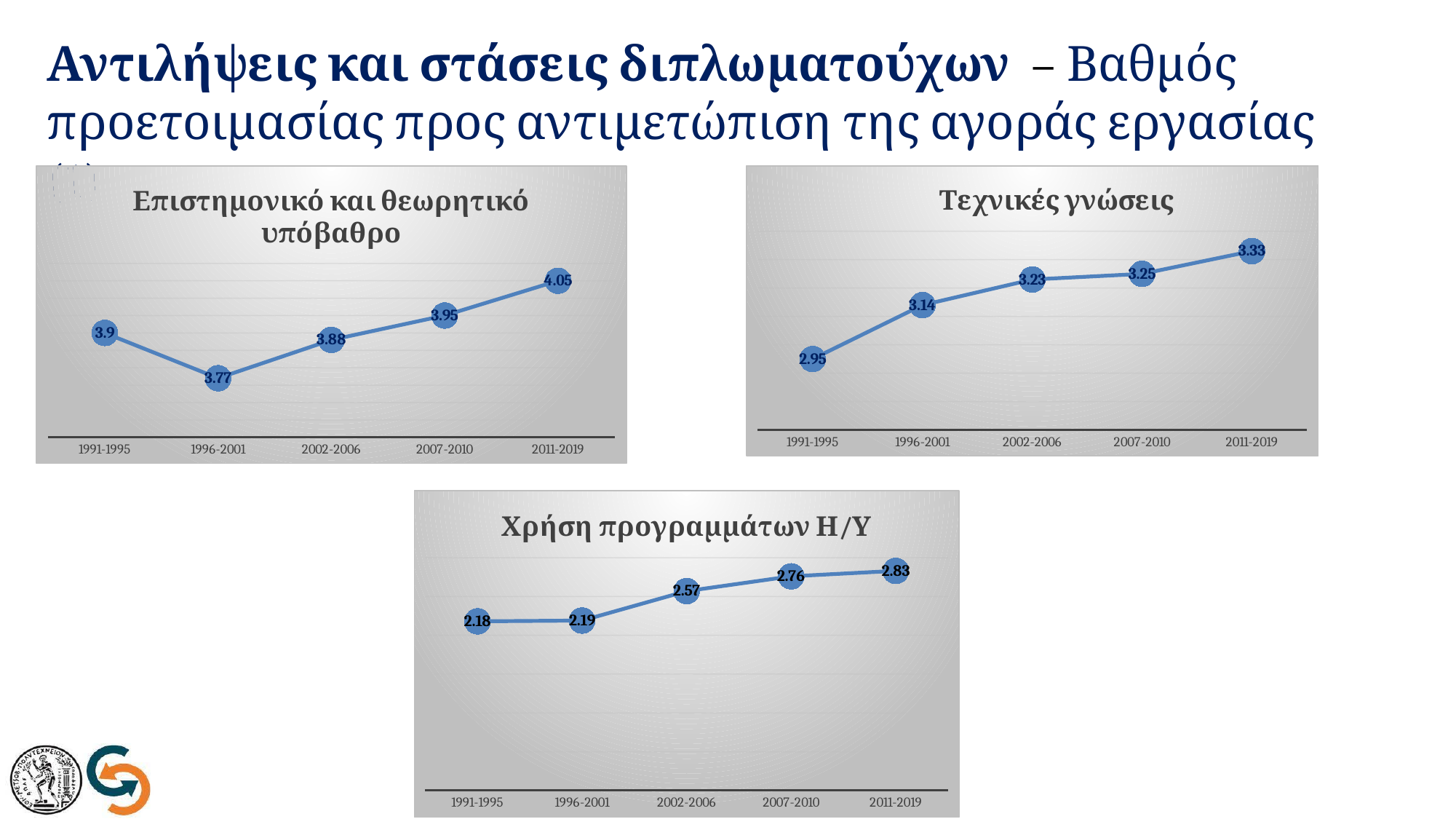
In the chart titled 'Τεχνικές γνώσεις', do the values rise or fall from 1991-1995 to 2011-2019? rise In the chart titled 'Χρήση προγραμμάτων Η/Υ', which period has the lowest value? 1991-1995 In the chart titled 'Χρήση προγραμμάτων Η/Υ', how many data points are plotted? 5 In the chart titled 'Χρήση προγραμμάτων Η/Υ', what is the difference between the values for 2007-2010 and 2002-2006? 0.19 In the chart titled 'Χρήση προγραμμάτων Η/Υ', what is the value for 2002-2006? 2.57 In the chart titled 'Επιστημονικό και θεωρητικό υπόβαθρο', what is the value for 1996-2001? 3.77 In the chart titled 'Τεχνικές γνώσεις', what is the value for 1991-1995? 2.95 In the chart titled 'Τεχνικές γνώσεις', what is the difference between the values for 2011-2019 and 1991-1995? 0.38 What kind of chart is the chart titled 'Τεχνικές γνώσεις'? line chart In the chart titled 'Επιστημονικό και θεωρητικό υπόβαθρο', which is larger: the value for 1991-1995 or the value for 2002-2006? 1991-1995 In the chart titled 'Επιστημονικό και θεωρητικό υπόβαθρο', which period has the highest value? 2011-2019 In the chart titled 'Επιστημονικό και θεωρητικό υπόβαθρο', which period has the lowest value? 1996-2001